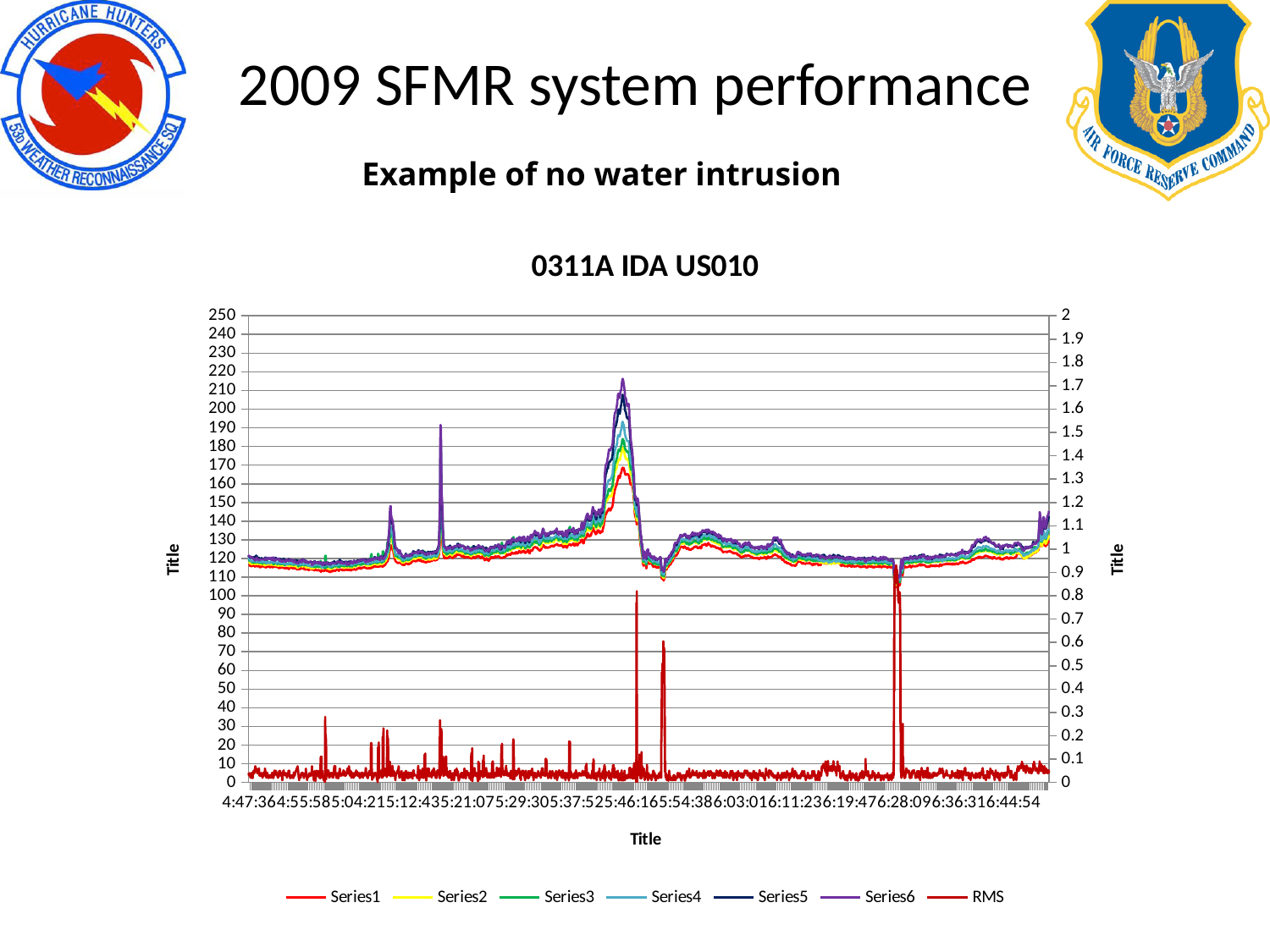
Is the value of Series1 at the start of the chart (around 4:47:36) greater or less than 150 on the left axis? less Is the highest spike of the RMS line greater or less than 150 on the left axis? less What kind of chart is shown on the slide? line chart Over most of the chart, which line is higher, Series1 or the RMS line? Series1 How many series does the legend list? 7 Is the highest peak of Series1 greater or less than 180 on the left axis? less What is the title of the chart? 0311A IDA US010 At the main peak near 5:46:16, which series reaches a higher value, Series6 or Series1? Series6 What is the highest value shown on the left vertical axis? 250